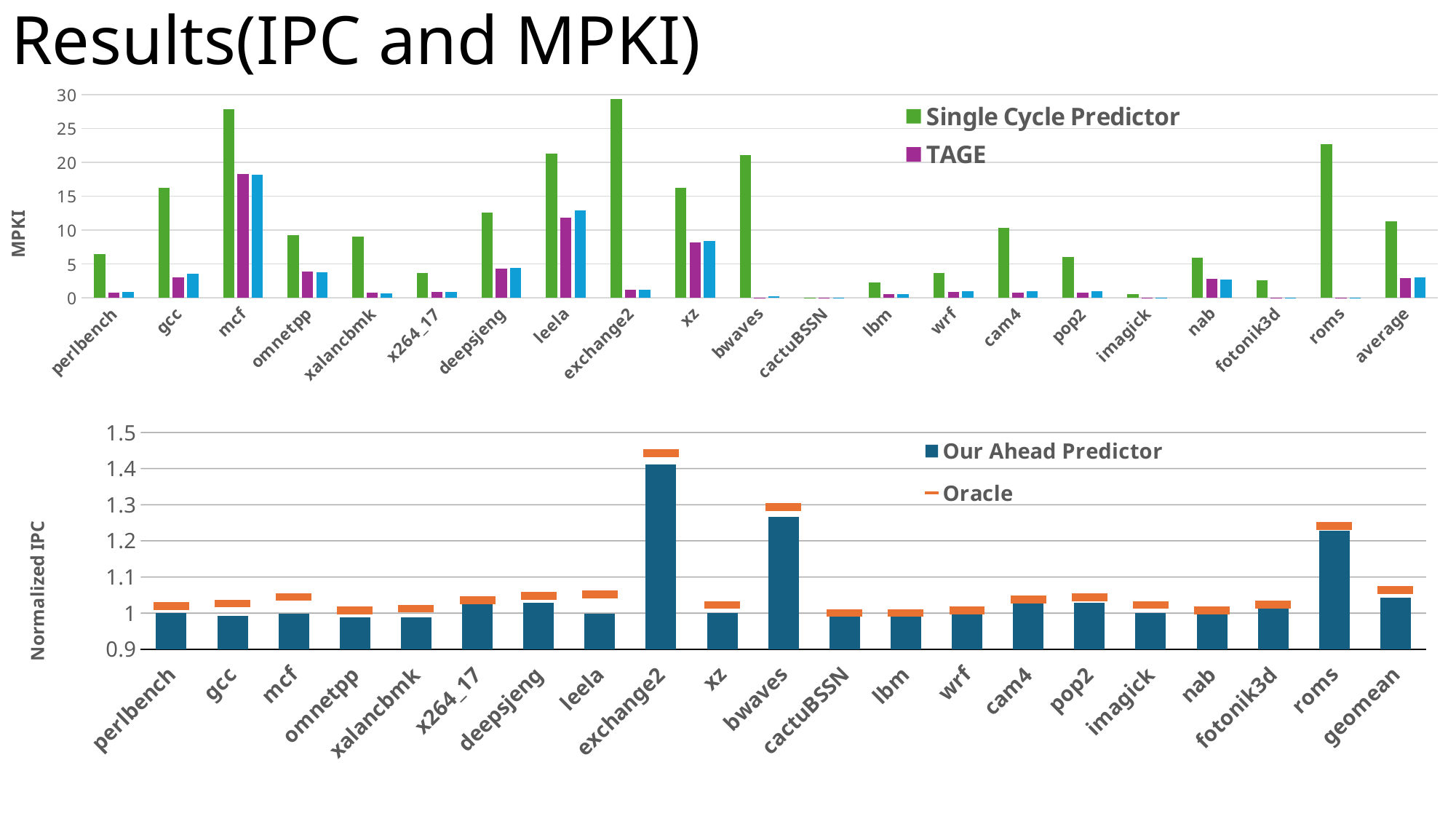
In the top MPKI chart, which is larger, the TAGE value for leela or the TAGE value for xz? leela In the bottom Normalized IPC chart, is the Oracle value for exchange2 greater or less than 1.4? greater In the top MPKI chart, is the Single Cycle Predictor value for mcf greater or less than 25? greater How many series does the legend of the bottom Normalized IPC chart list? 2 In the top MPKI chart, is the Single Cycle Predictor value for roms greater or less than 20? greater In the top MPKI chart, which category has the highest TAGE value? mcf How many categories are shown on the x axis of the top MPKI chart? 21 What kind of chart is the bottom Normalized IPC chart? bar chart In the bottom Normalized IPC chart, which category has the highest Our Ahead Predictor value? exchange2 In the top MPKI chart, which category has the highest Single Cycle Predictor value? exchange2